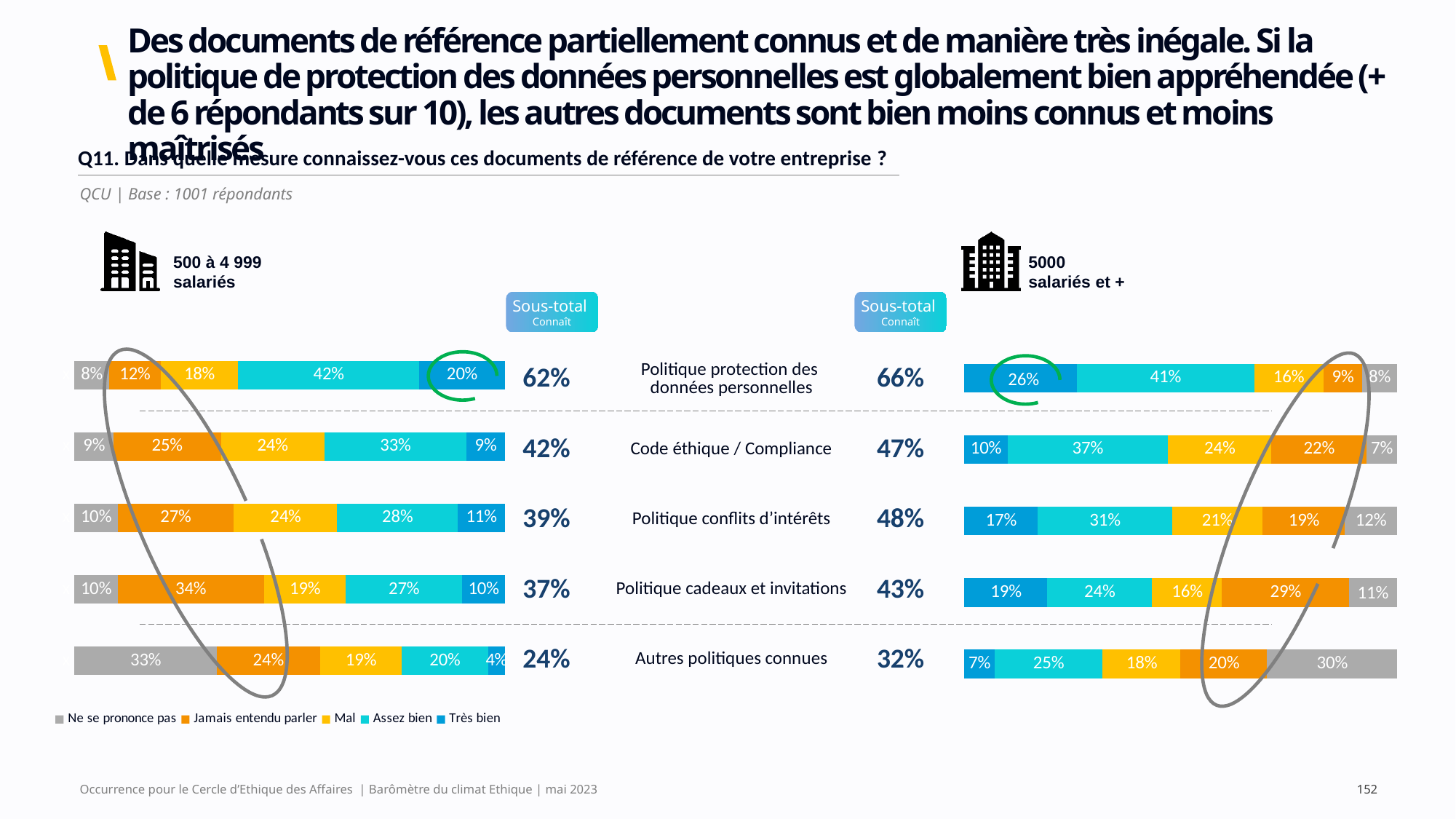
In the right chart (5000 salariés et +), what is the 'Ne se prononce pas' value for 'Autres politiques connues'? 30% What kind of chart is used on this slide? Stacked bar chart In the left chart (500 à 4 999 salariés), what is the 'Assez bien' value for 'Politique protection des données personnelles'? 42% In the right chart (5000 salariés et +), what is the 'Très bien' value for 'Politique protection des données personnelles'? 26% How many series does the legend list? 5 For 'Politique conflits d'intérêts', is the 'Très bien' value larger in the left chart (500 à 4 999 salariés) or in the right chart (5000 salariés et +)? Right chart (5000 salariés et +) How many categories (documents) are shown in each chart? 5 In the right chart (5000 salariés et +), which category has the lowest 'Sous-total Connaît' value? Autres politiques connues What is the difference between the 'Sous-total Connaît' for 'Code éthique / Compliance' in the right chart (47%) and in the left chart (42%)? 5% In the left chart (500 à 4 999 salariés), which category has the highest 'Sous-total Connaît' value? Politique protection des données personnelles In the left chart (500 à 4 999 salariés), what is the 'Jamais entendu parler' value for 'Politique cadeaux et invitations'? 34% In the left chart (500 à 4 999 salariés), what is the combined 'Assez bien' plus 'Très bien' total for 'Code éthique / Compliance' (33% + 9%)? 42%